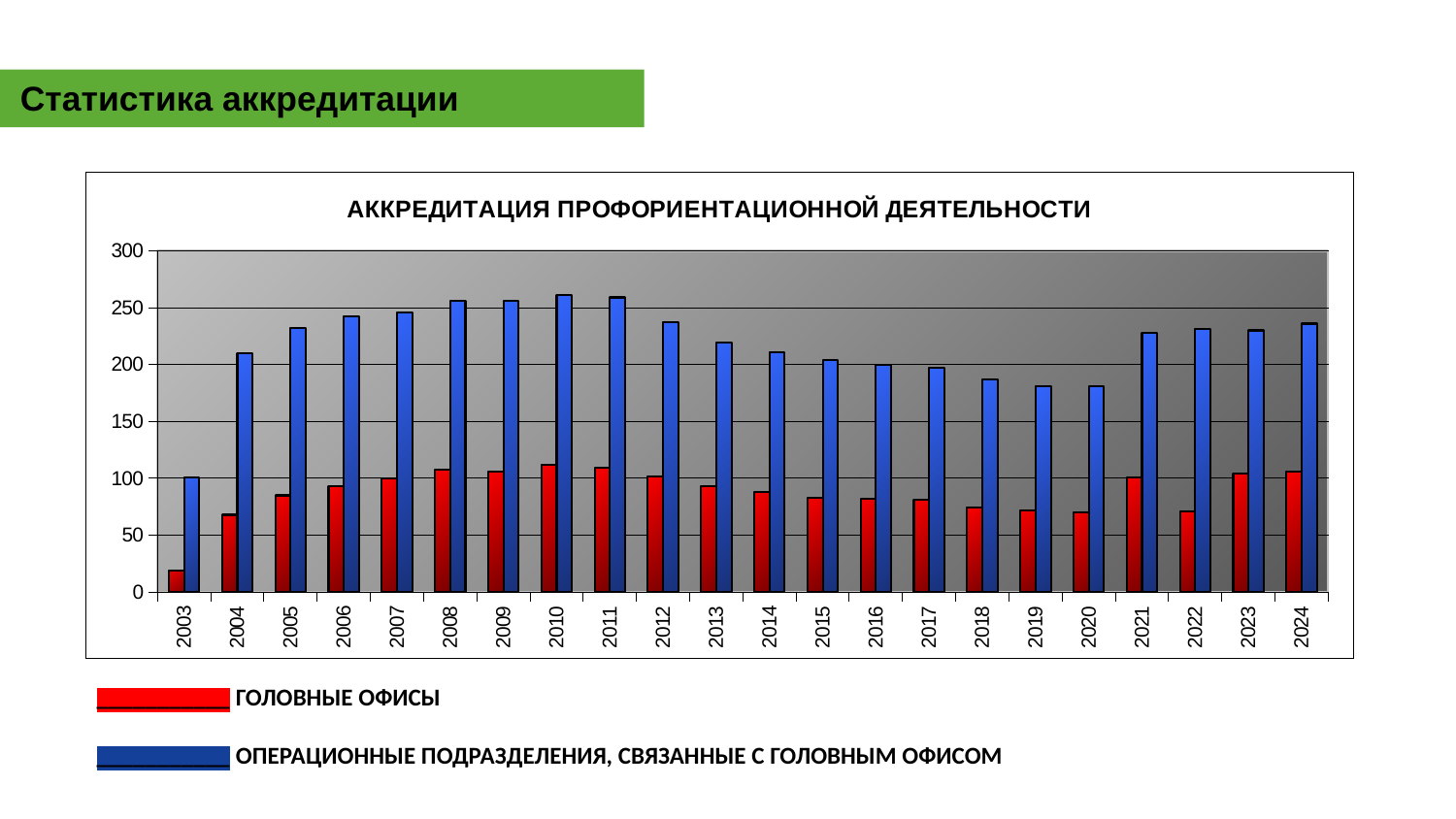
How many series does the legend list? 2 Is the value for ОПЕРАЦИОННЫЕ ПОДРАЗДЕЛЕНИЯ, СВЯЗАННЫЕ С ГОЛОВНЫМ ОФИСОМ in 2010 greater or less than 250? greater Is the value for ОПЕРАЦИОННЫЕ ПОДРАЗДЕЛЕНИЯ, СВЯЗАННЫЕ С ГОЛОВНЫМ ОФИСОМ in 2020 greater or less than 200? less Which year has the lowest value for ОПЕРАЦИОННЫЕ ПОДРАЗДЕЛЕНИЯ, СВЯЗАННЫЕ С ГОЛОВНЫМ ОФИСОМ? 2003 Which is larger for ОПЕРАЦИОННЫЕ ПОДРАЗДЕЛЕНИЯ, СВЯЗАННЫЕ С ГОЛОВНЫМ ОФИСОМ: the value in 2008 or in 2013? 2008 How many years are shown on the x axis? 22 What is the title of the chart? АККРЕДИТАЦИЯ ПРОФОРИЕНТАЦИОННОЙ ДЕЯТЕЛЬНОСТИ Do the values for ОПЕРАЦИОННЫЕ ПОДРАЗДЕЛЕНИЯ, СВЯЗАННЫЕ С ГОЛОВНЫМ ОФИСОМ rise or fall from 2011 to 2020? fall What kind of chart is shown on the slide? bar chart Is the value for ГОЛОВНЫЕ ОФИСЫ in 2018 greater or less than 100? less Which year has the lowest value for ГОЛОВНЫЕ ОФИСЫ? 2003